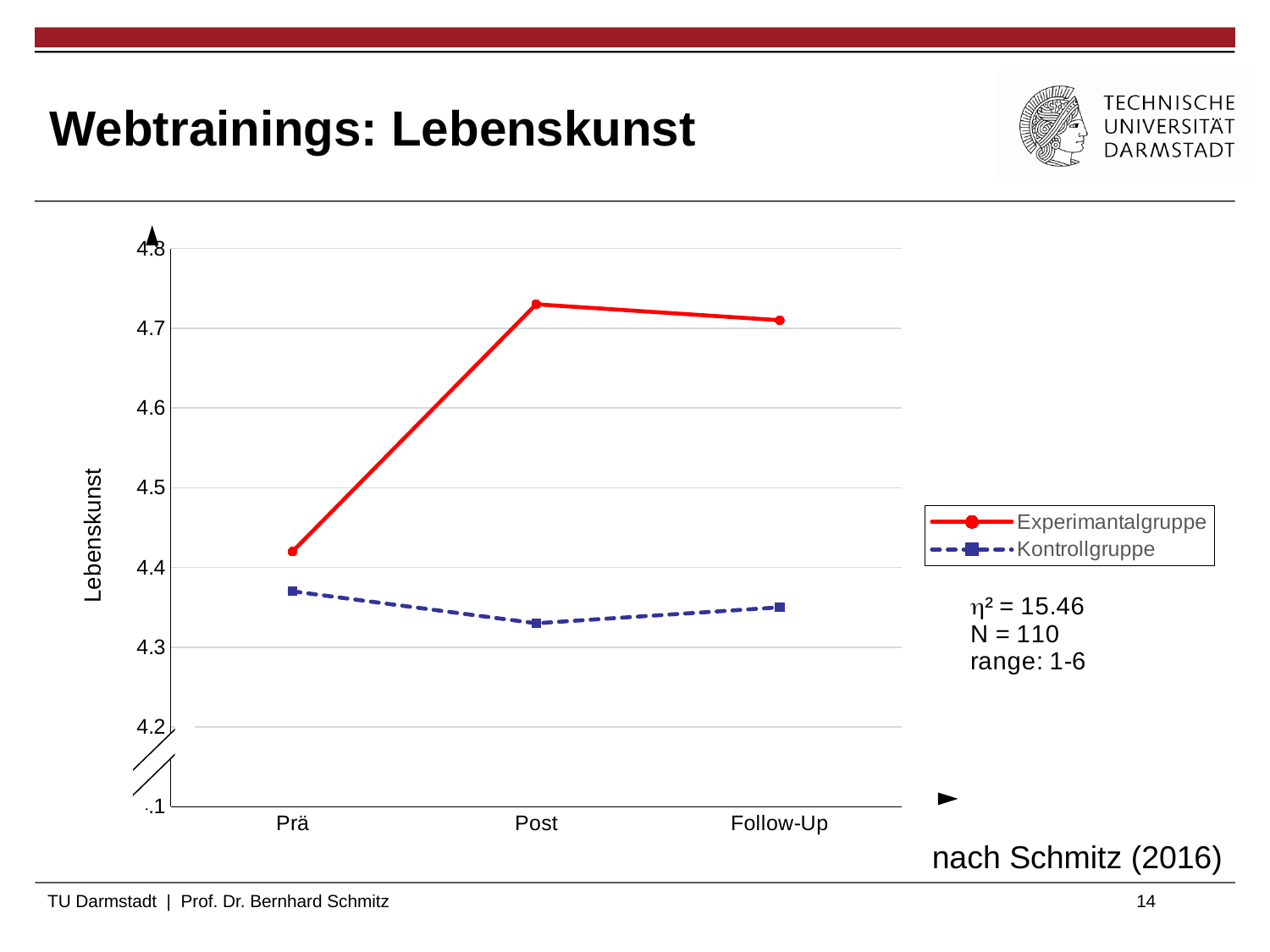
What kind of chart is shown on the slide? line chart Which series has the higher value at Prä? Experimantalgruppe Is the value for Experimantalgruppe at Post greater or less than 4.6? greater Does the Experimantalgruppe line rise or fall from Prä to Post? rise Is the value for Experimantalgruppe at Follow-Up greater or less than 4.6? greater Is the value for Experimantalgruppe at Prä greater or less than 4.5? less Does the Kontrollgruppe line rise or fall from Prä to Post? fall How many measurement points are shown along the x axis? 3 How many series does the legend list? 2 What is the label of the y axis? Lebenskunst Which series has the higher value at Post? Experimantalgruppe